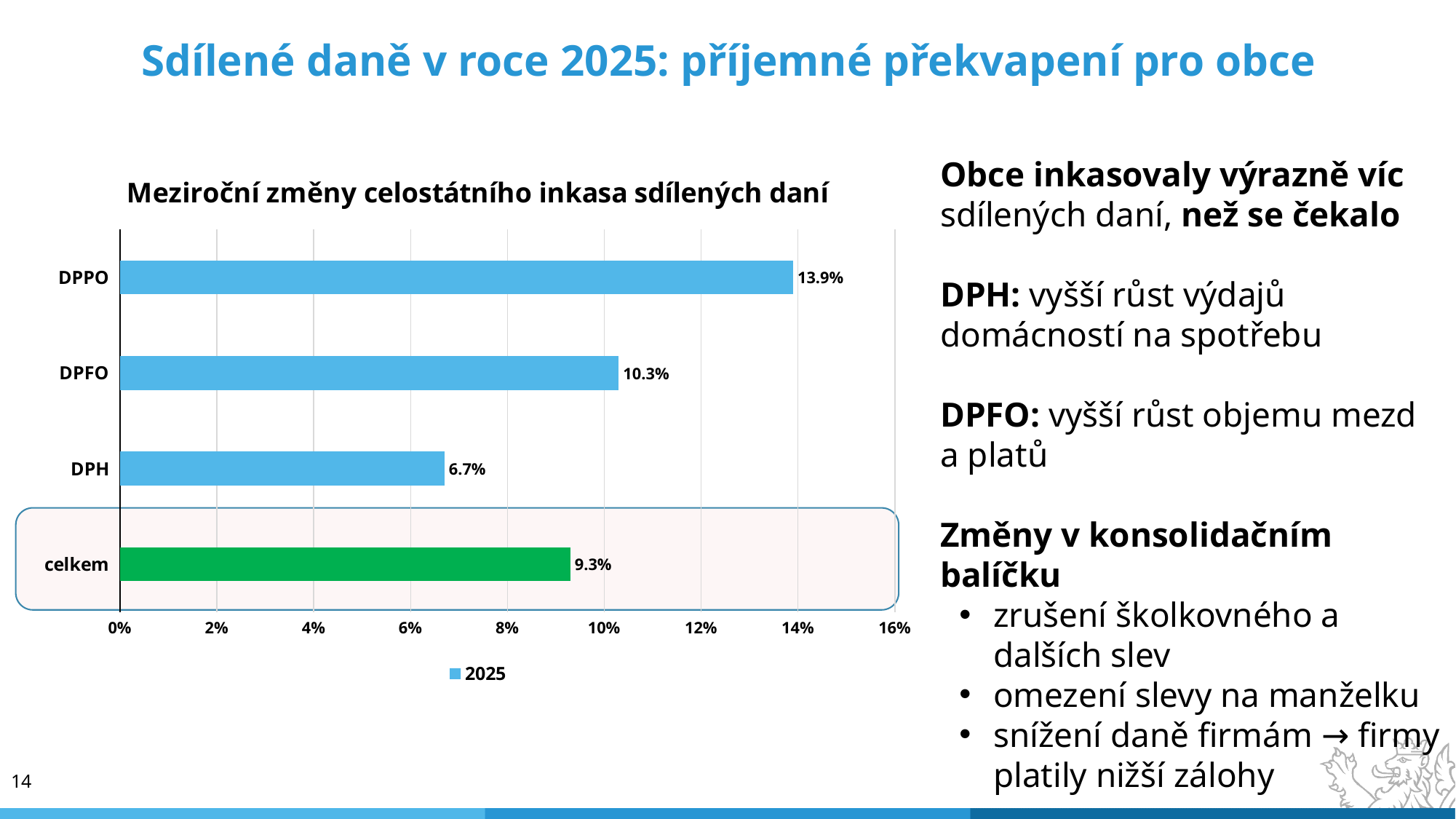
What is the title of the chart? Meziroční změny celostátního inkasa sdílených daní What is the difference between the values for DPPO and DPH? 7.2% What kind of chart is shown on the slide? bar chart What is the value for celkem? 9.3% How many categories are shown in the chart? 4 What is the value for DPPO? 13.9% What is the value for DPFO? 10.3% Which is larger, the value for DPFO or the value for celkem? DPFO What is the value for DPH? 6.7% Which category has the highest value? DPPO Which category has the lowest value? DPH Is the value for DPH greater or less than 8%? less